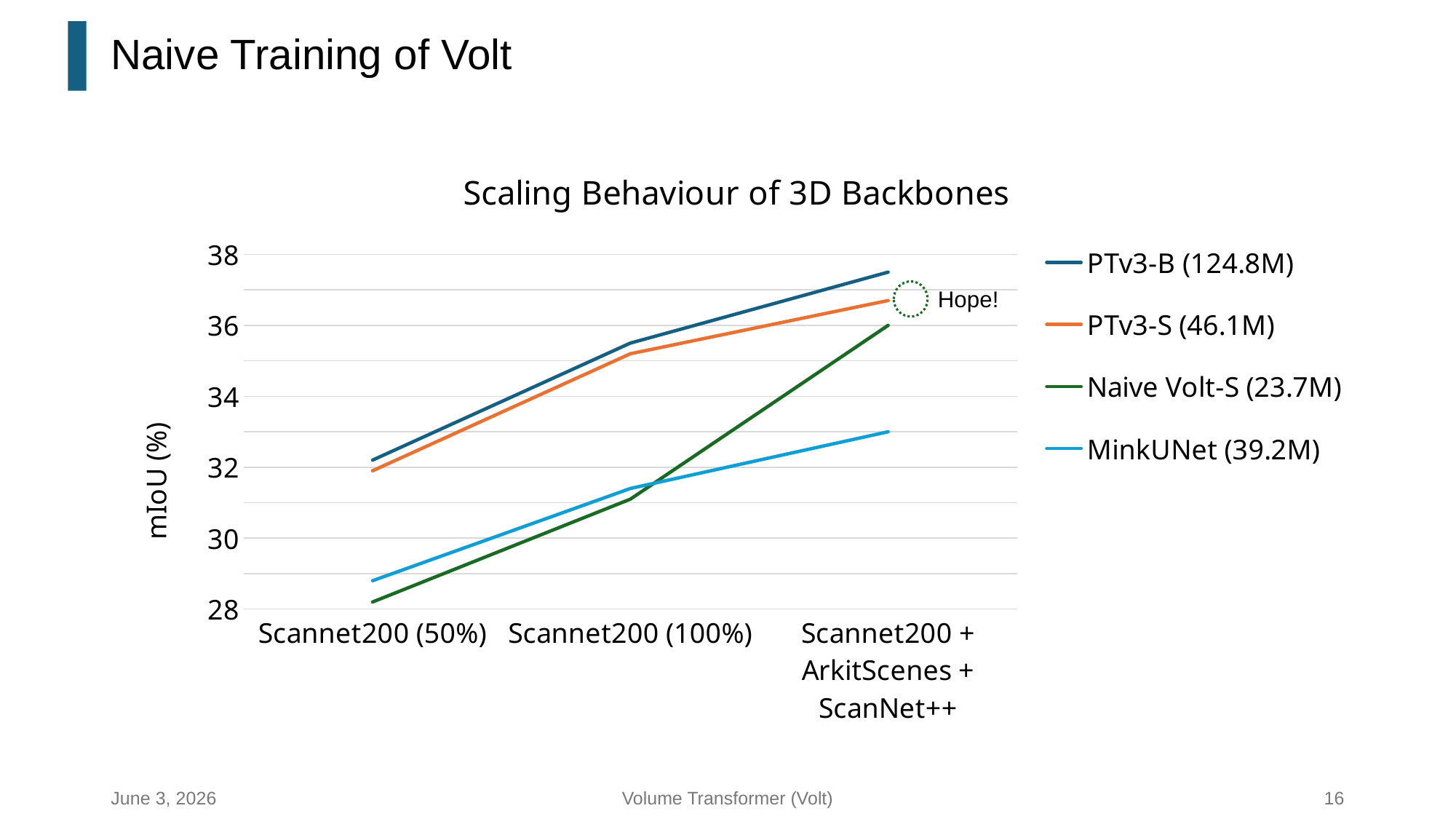
Is the value for MinkUNet (39.2M) at Scannet200 (100%) greater or less than 32? less Is the value for PTv3-B (124.8M) at Scannet200 + ArkitScenes + ScanNet++ greater or less than 36? greater How many series does the legend list? 4 Which series has the lowest value at Scannet200 + ArkitScenes + ScanNet++? MinkUNet (39.2M) How many categories are shown along the x axis? 3 What is the label of the y axis? mIoU (%) Does the value for Naive Volt-S (23.7M) rise or fall from Scannet200 (50%) to Scannet200 + ArkitScenes + ScanNet++? rise Is the value for Naive Volt-S (23.7M) at Scannet200 (50%) greater or less than 30? less Which series has the lowest value at Scannet200 (50%)? Naive Volt-S (23.7M) Which series has the highest value at Scannet200 + ArkitScenes + ScanNet++? PTv3-B (124.8M) At Scannet200 + ArkitScenes + ScanNet++, which is larger: Naive Volt-S (23.7M) or MinkUNet (39.2M)? Naive Volt-S (23.7M) What kind of chart is shown on the slide? line chart